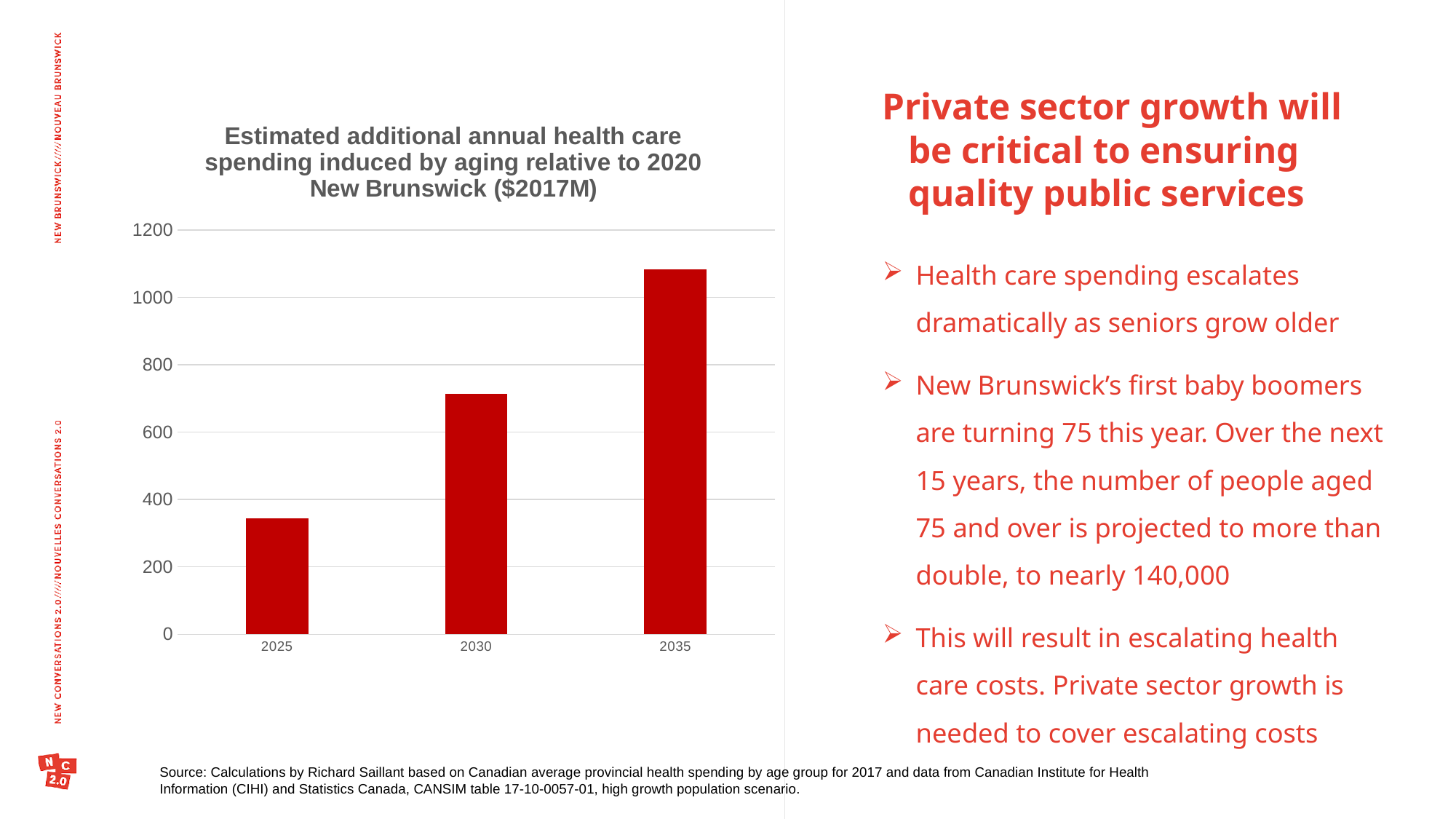
Is the value for 2025 greater or less than 400? less What colour are the bars in the chart? red Which year has the highest estimated additional annual health care spending? 2035 Is the value for 2035 greater or less than 1000? greater How many years are plotted on the x axis of the chart? 3 Do the values rise or fall from 2025 to 2035? rise What kind of chart is shown on the slide? bar chart Which year has the lowest estimated additional annual health care spending? 2025 Is the value for 2030 greater or less than 600? greater Which is larger, the value for 2030 or the value for 2025? 2030